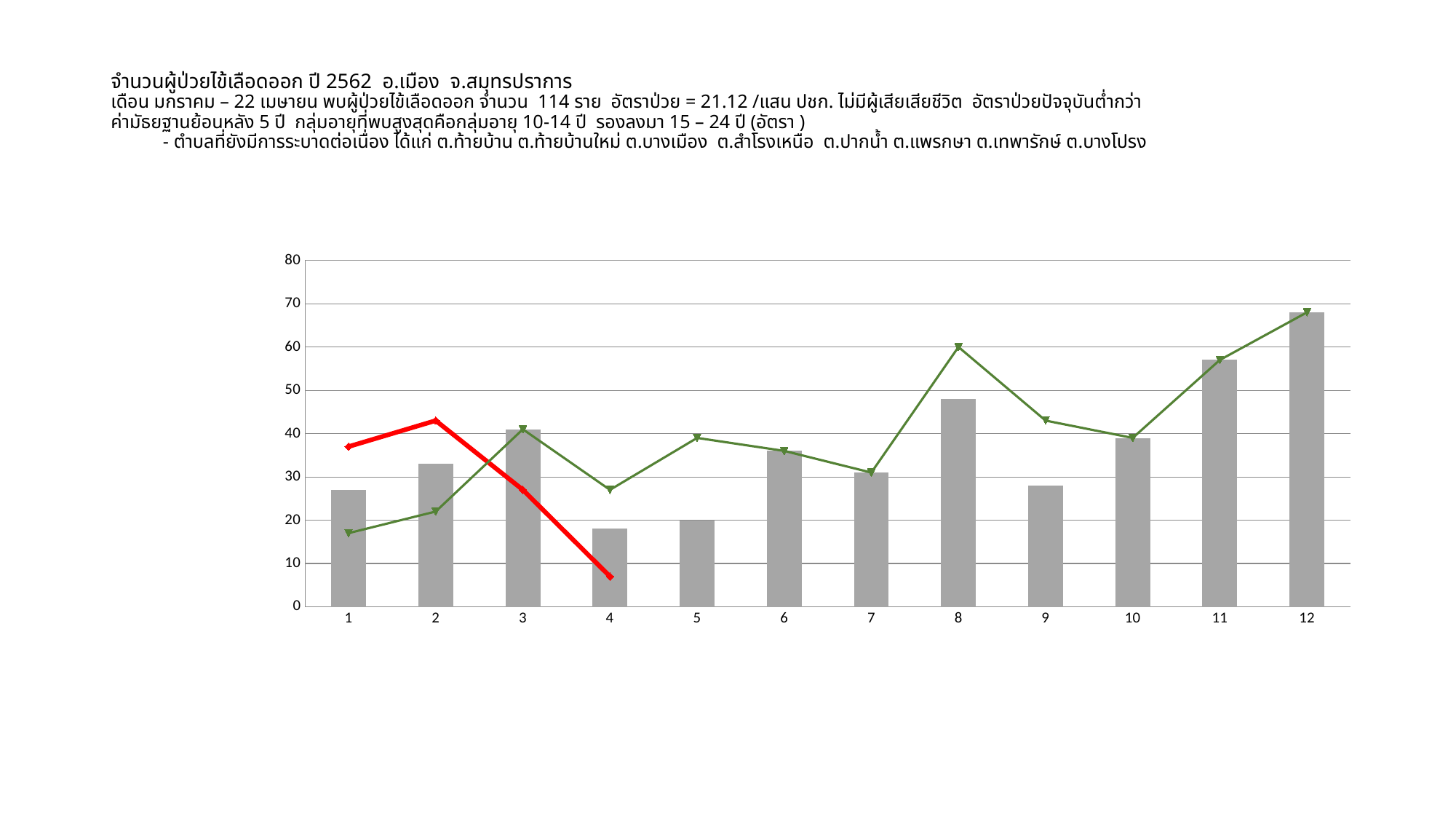
What kind of chart is shown on the slide? bar chart with line series Does the green line rise or fall from category 10 to category 12? rise Does the red line rise or fall from category 2 to category 4? fall How many categories are shown on the x axis? 12 Which bar is taller, category 3 or category 2? 3 Is the bar value for category 12 greater or less than 60? greater Which bar is taller, category 11 or category 8? 11 Which category has the tallest bar? 12 Which category has the shortest bar? 4 Is the bar value for category 4 greater or less than 20? less Is the bar value for category 8 greater or less than 40? greater How many data points does the red line have? 4